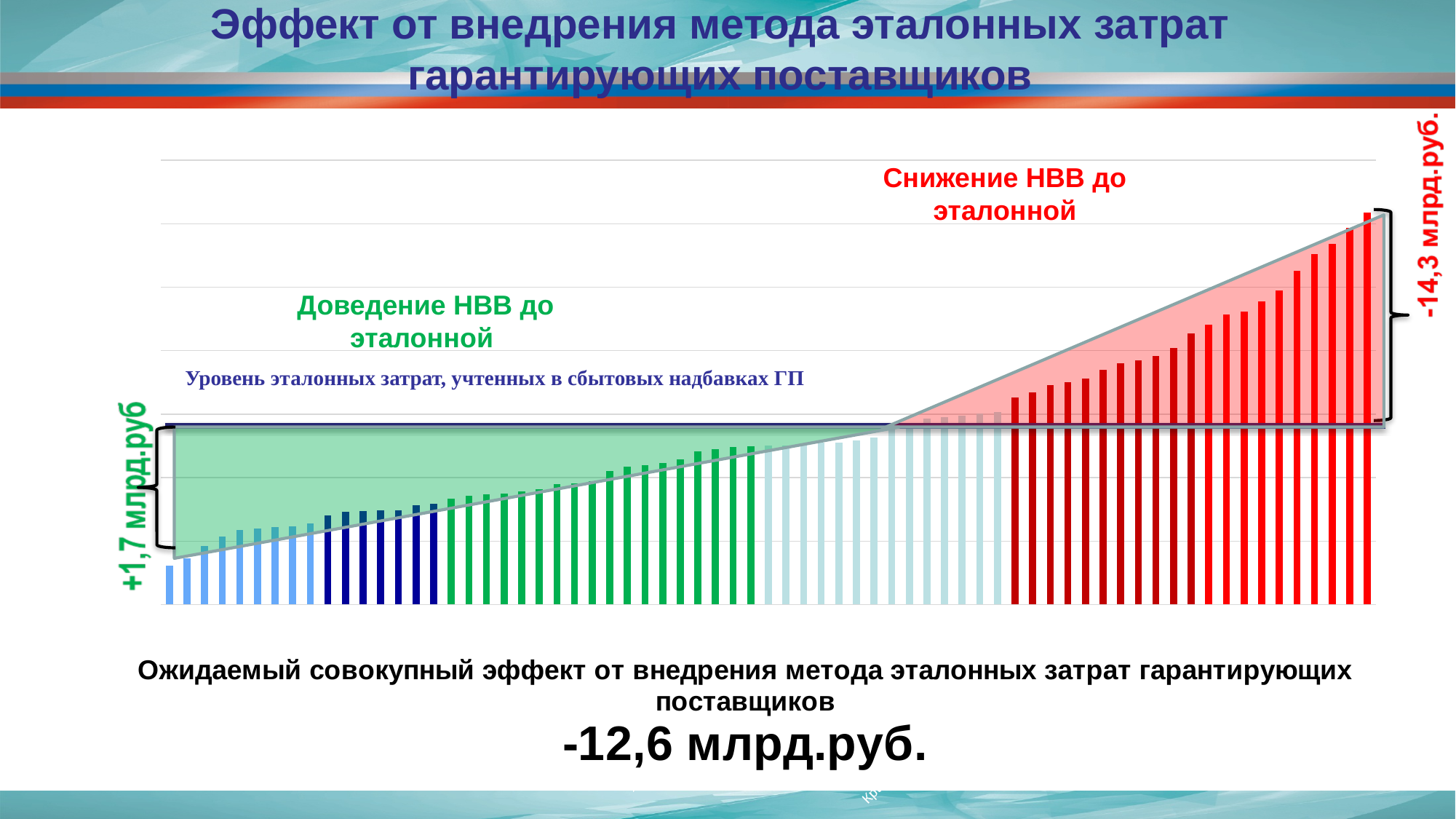
Which is larger in magnitude: the increase annotated on the left (+1,7 млрд.руб) or the decrease annotated on the right (-14,3 млрд.руб.)? the decrease (-14,3 млрд.руб.) What is the expected combined effect (Ожидаемый совокупный эффект) stated below the chart? -12,6 млрд.руб. What value is annotated for the red region labelled "Снижение НВВ до эталонной"? -14,3 млрд.руб. What kind of chart is shown on the slide? bar chart Do the bar heights rise or fall from left to right across the chart? rise What colour are the bars that extend above the horizontal reference line on the right side of the chart? red What is the label of the horizontal line drawn across the chart? Уровень эталонных затрат, учтенных в сбытовых надбавках ГП What value is annotated for the green region labelled "Доведение НВВ до эталонной"? +1,7 млрд.руб